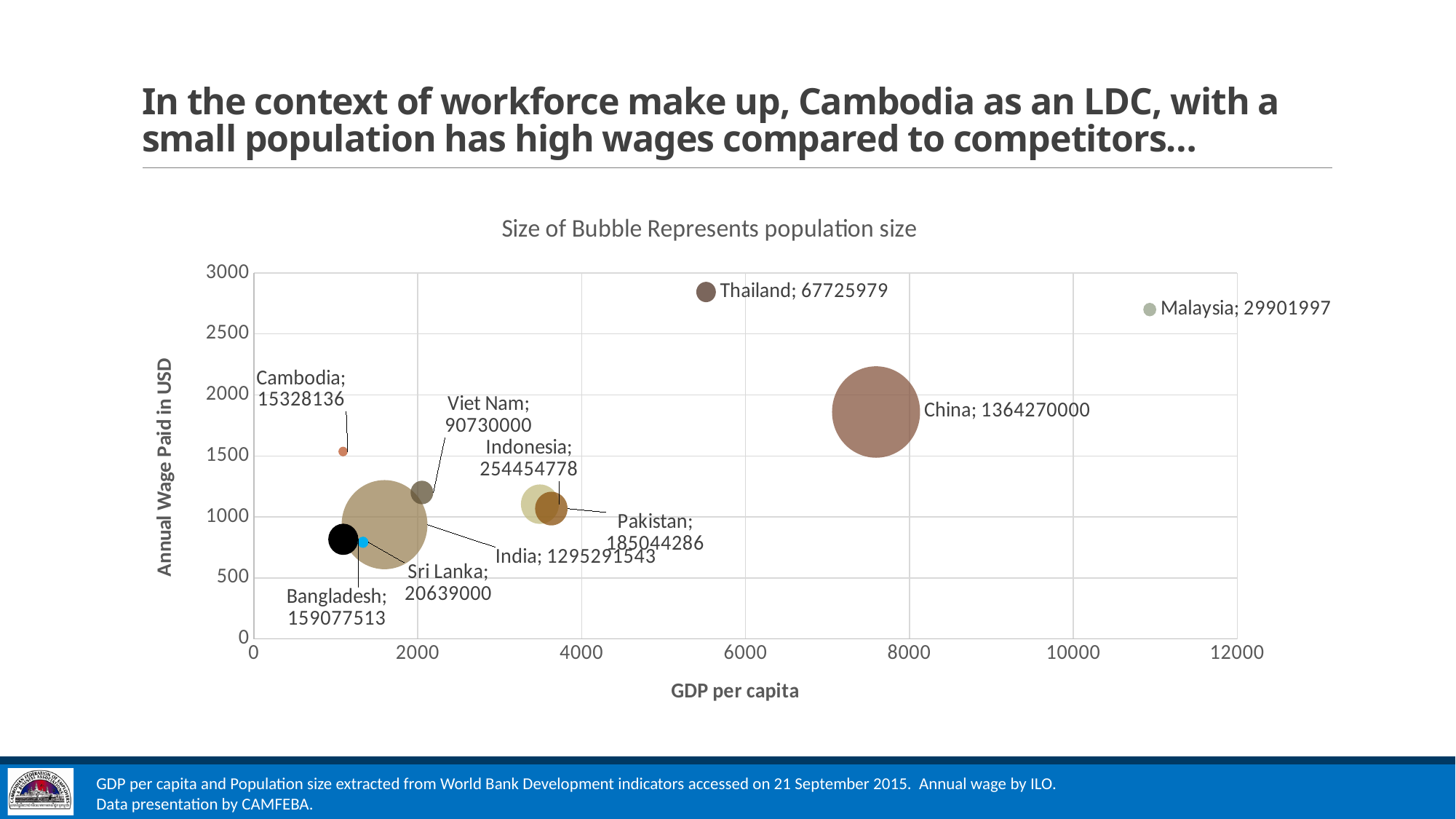
What is the difference between the population labels of China and India? 68978457 What does the chart title say the size of each bubble represents? Population size What population size is shown in the data label for China? 1364270000 Which country has the smallest population according to the data labels? Cambodia Which country has the largest population according to the data labels? China What population size is shown in the data label for Viet Nam? 90730000 Is the annual wage value for Thailand greater or less than 2500? greater Is the GDP per capita value for Malaysia greater or less than 10000? greater Which country has the higher annual wage, Thailand or China? Thailand How many countries are plotted as bubbles on the chart? 10 What population size is shown in the data label for Cambodia? 15328136 What kind of chart is shown on the slide? Bubble chart